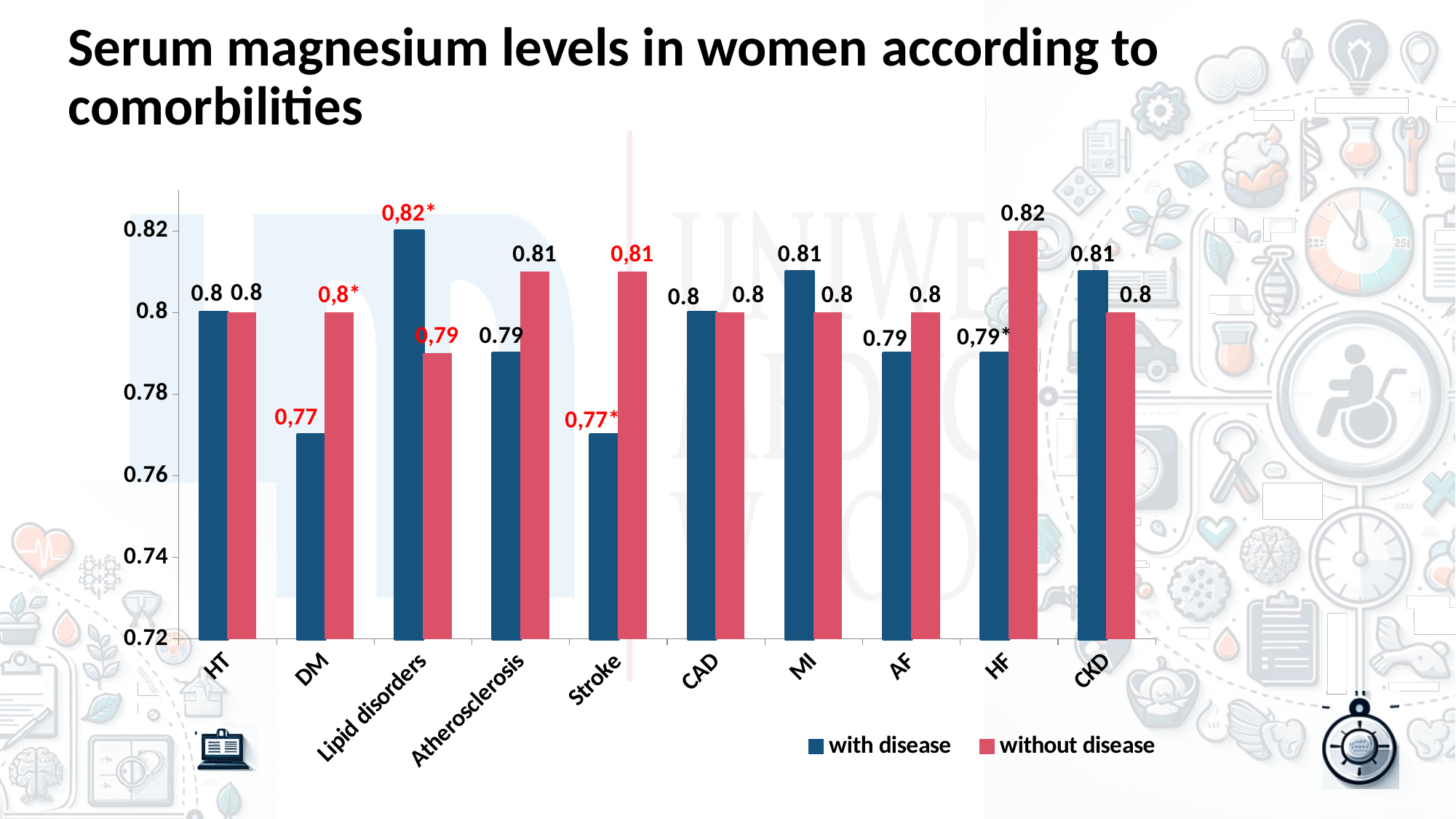
What is the value for women without disease in the HF category? 0.82 Which colour represents the 'with disease' series in the legend? dark blue What type of chart is shown on the slide? bar chart What is the value for women with disease in the CKD category? 0.81 In the HF category, what is the difference between the 'without disease' and 'with disease' values? 0.03 What is the value for women without disease in the Lipid disorders category? 0,79 Which category has the highest value for the 'with disease' series? Lipid disorders How many comorbidity categories are shown on the x axis? 10 How many series does the legend list? 2 In the MI category, which is larger: the value for women with disease or without disease? with disease Which category has the lowest value for the 'without disease' series? Lipid disorders What is the serum magnesium level for women with disease in the DM category? 0,77